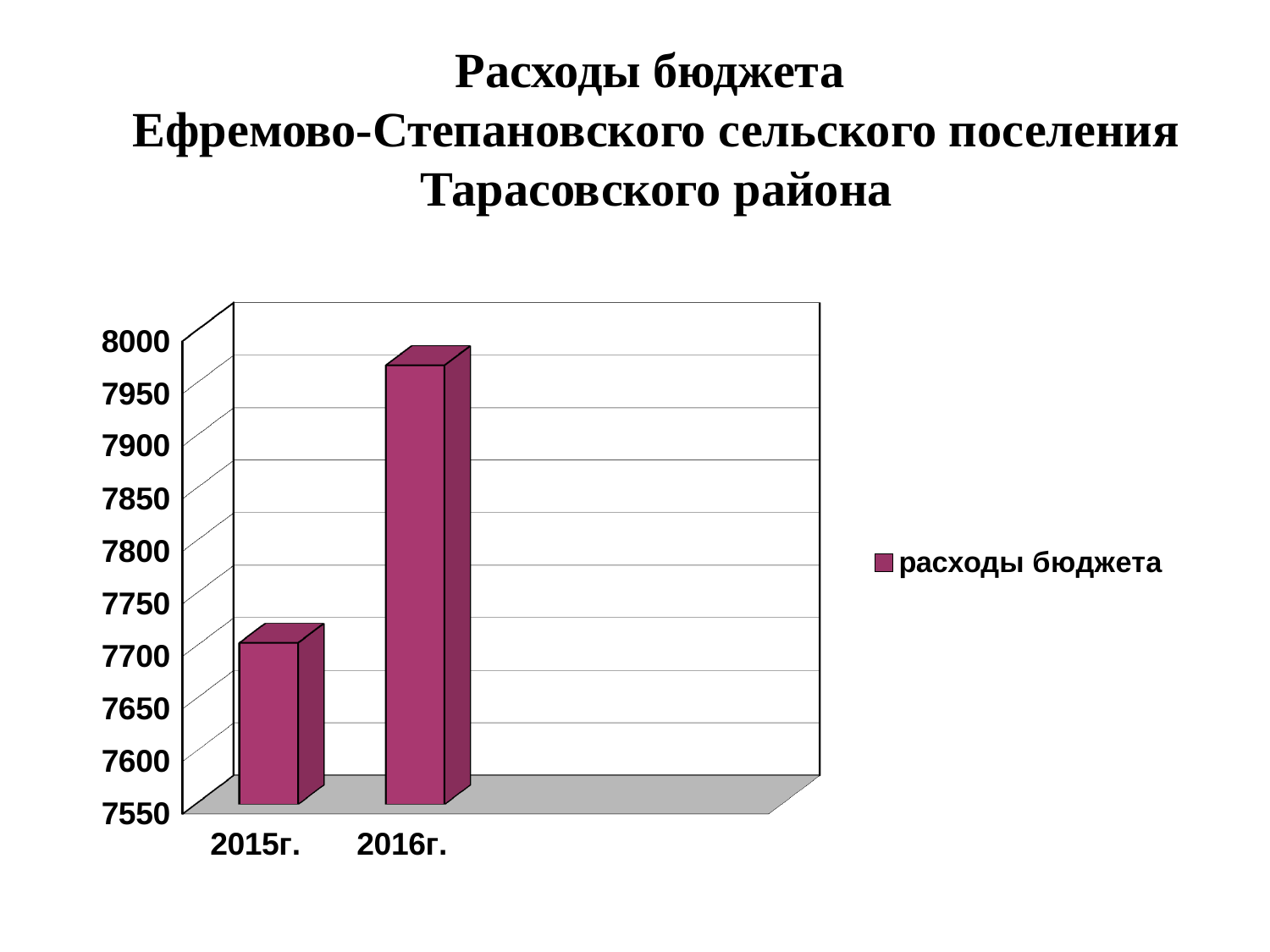
How many categories are plotted on the x axis of the chart? 2 Is the value for 2016г. greater or less than 8000? less Do the values rise or fall from 2015г. to 2016г.? rise Is the value for 2015г. greater or less than 7750? less Is the value for 2015г. greater or less than 7650? greater How many series does the chart's legend list? 1 Which year has the higher budget expenditure, 2015г. or 2016г.? 2016г. What kind of chart is shown on the slide? bar chart Which category has the highest value in the chart? 2016г. Which category has the lowest value in the chart? 2015г. What is the name of the series shown in the chart's legend? расходы бюджета